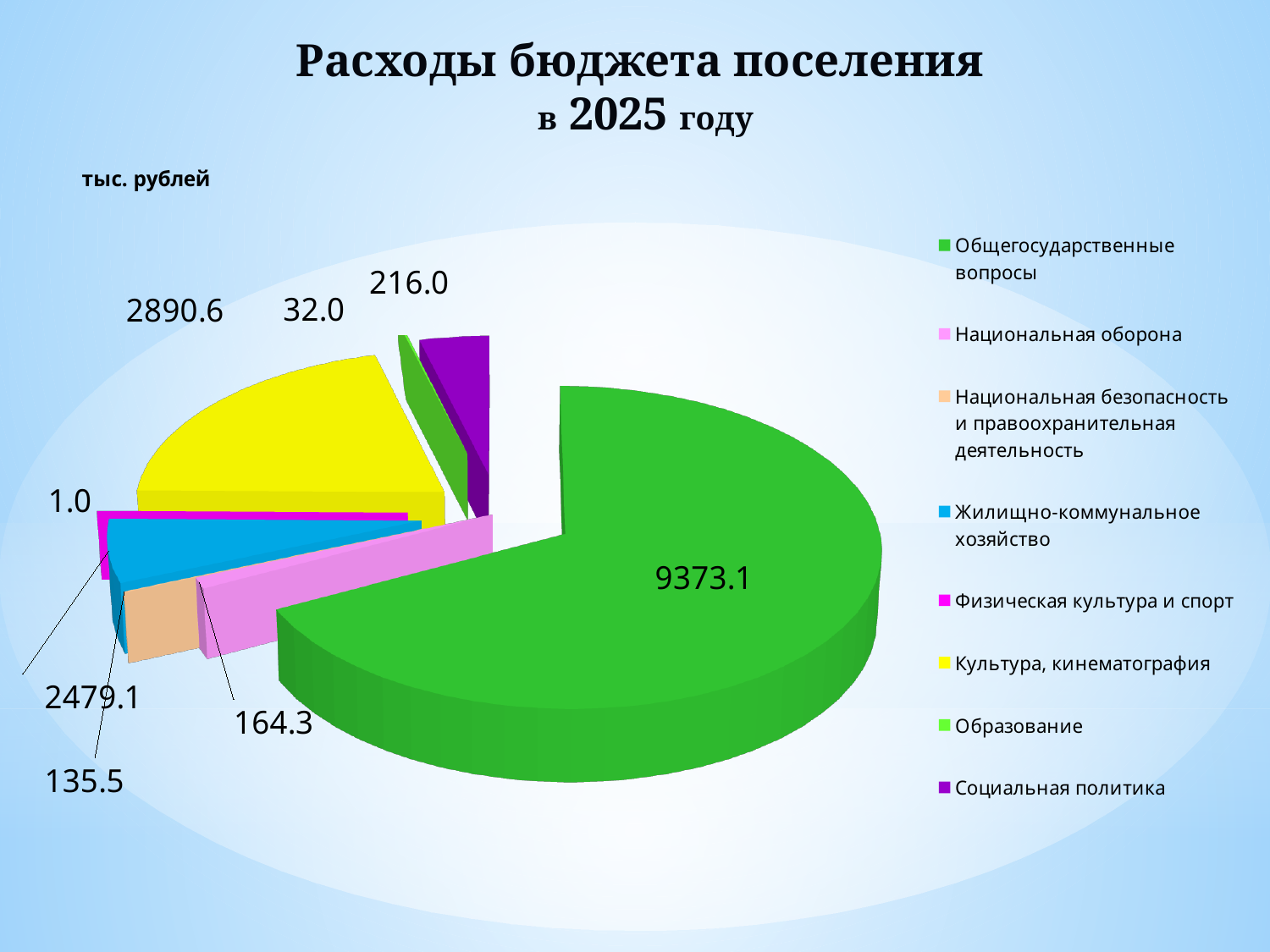
What kind of chart is shown on the slide? Pie chart Which category has the smallest value? Физическая культура и спорт What is the value for Образование? 32.0 What is the value for Социальная политика? 216.0 Which is larger: Национальная оборона or Национальная безопасность и правоохранительная деятельность? Национальная оборона What is the difference between Культура, кинематография and Жилищно-коммунальное хозяйство? 411.5 Which category has the largest value? Общегосударственные вопросы What unit is indicated for the values on the chart? тыс. рублей What is the value for Культура, кинематография? 2890.6 What is the value for Общегосударственные вопросы? 9373.1 How many categories does the legend list? 8 What is the value for Жилищно-коммунальное хозяйство? 2479.1